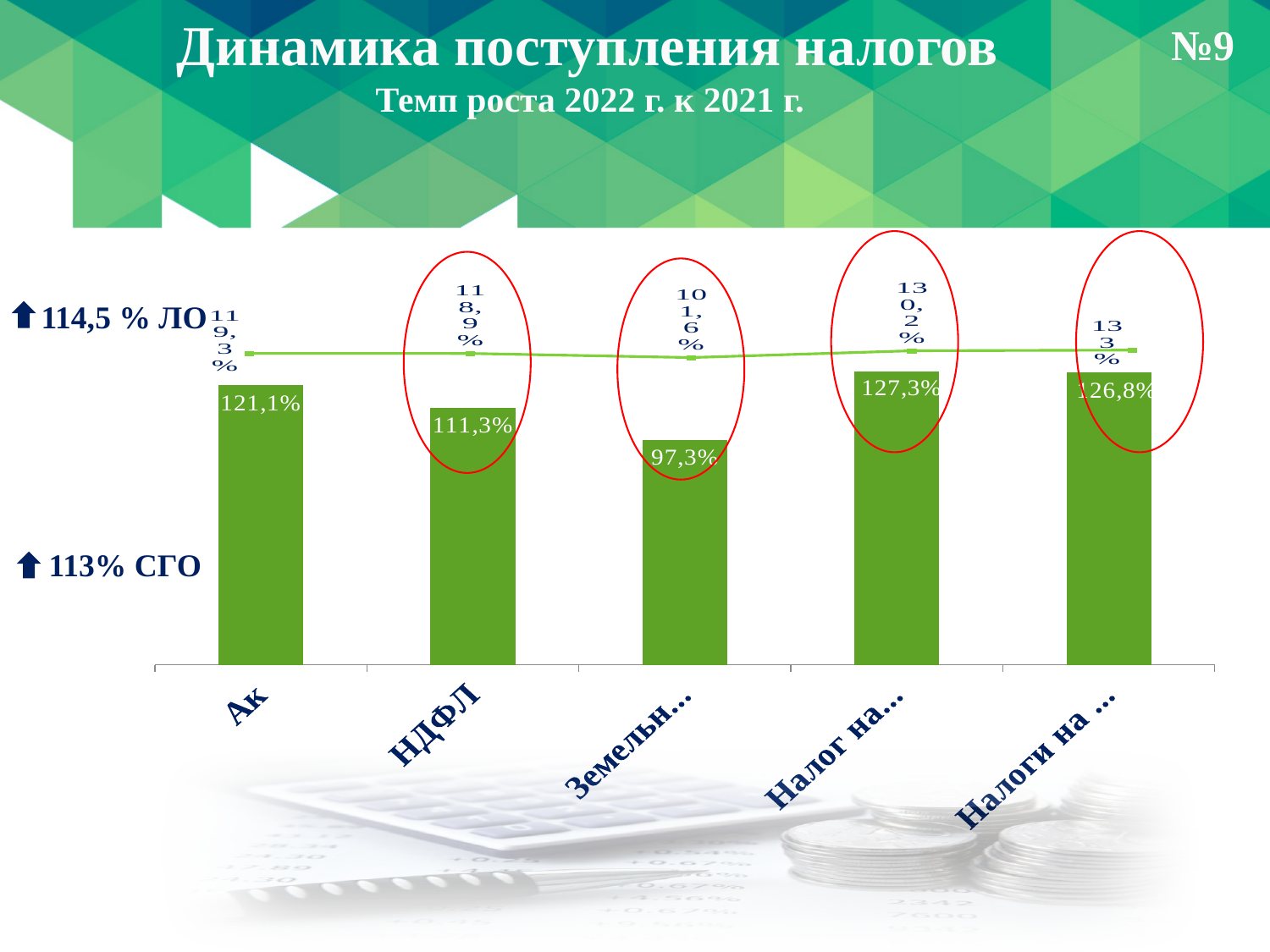
What is the main title of the slide? Динамика поступления налогов What is the bar value for Ак? 121,1% What is the highest bar value on the chart? 127,3% Which has the larger bar value, Ак or НДФЛ? Ак What is the bar value for НДФЛ? 111,3% What is the lowest bar value on the chart? 97,3% What is the line series value above the НДФЛ bar? 118,9% What is the value printed on the third bar (Земельн…)? 97,3% How many categories are shown on the x axis? 5 What is the difference between the bar values for Ак and НДФЛ? 9,8% What kind of chart is shown on the slide? Bar chart with a line series What is the value printed on the fourth bar (Налог на…)? 127,3%